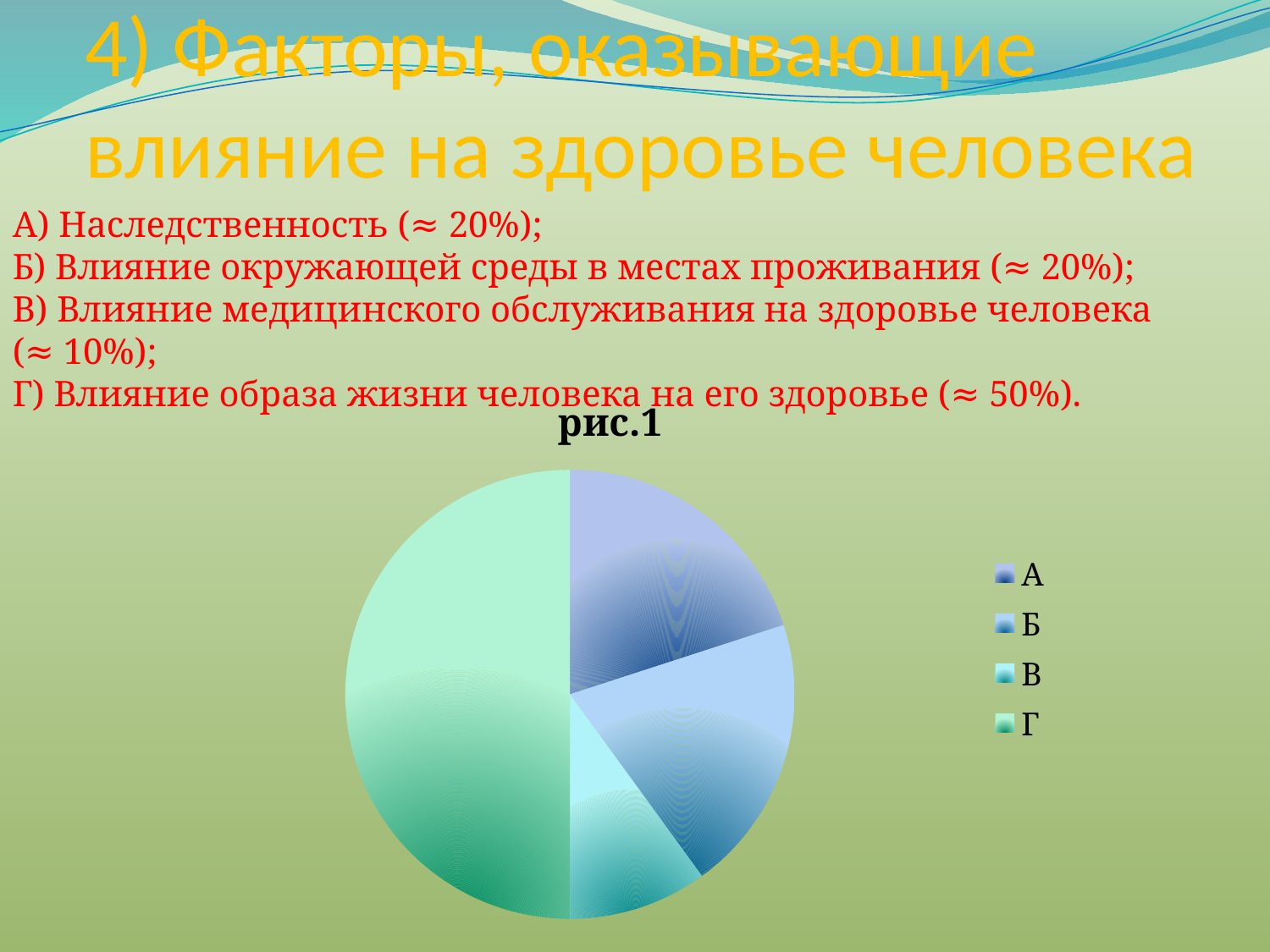
How many slices does the pie chart have? 4 Which category has the largest slice of the pie? Г What are the legend entries of the pie chart, in order? А, Б, В, Г Which slice is larger, Б or Г? Г Which slice is larger, Г or В? Г How many entries does the chart legend list? 4 Which slice is larger, А or В? А What is the title of the chart? рис.1 What kind of chart is shown on the slide? pie chart Which category has the smallest slice of the pie? В